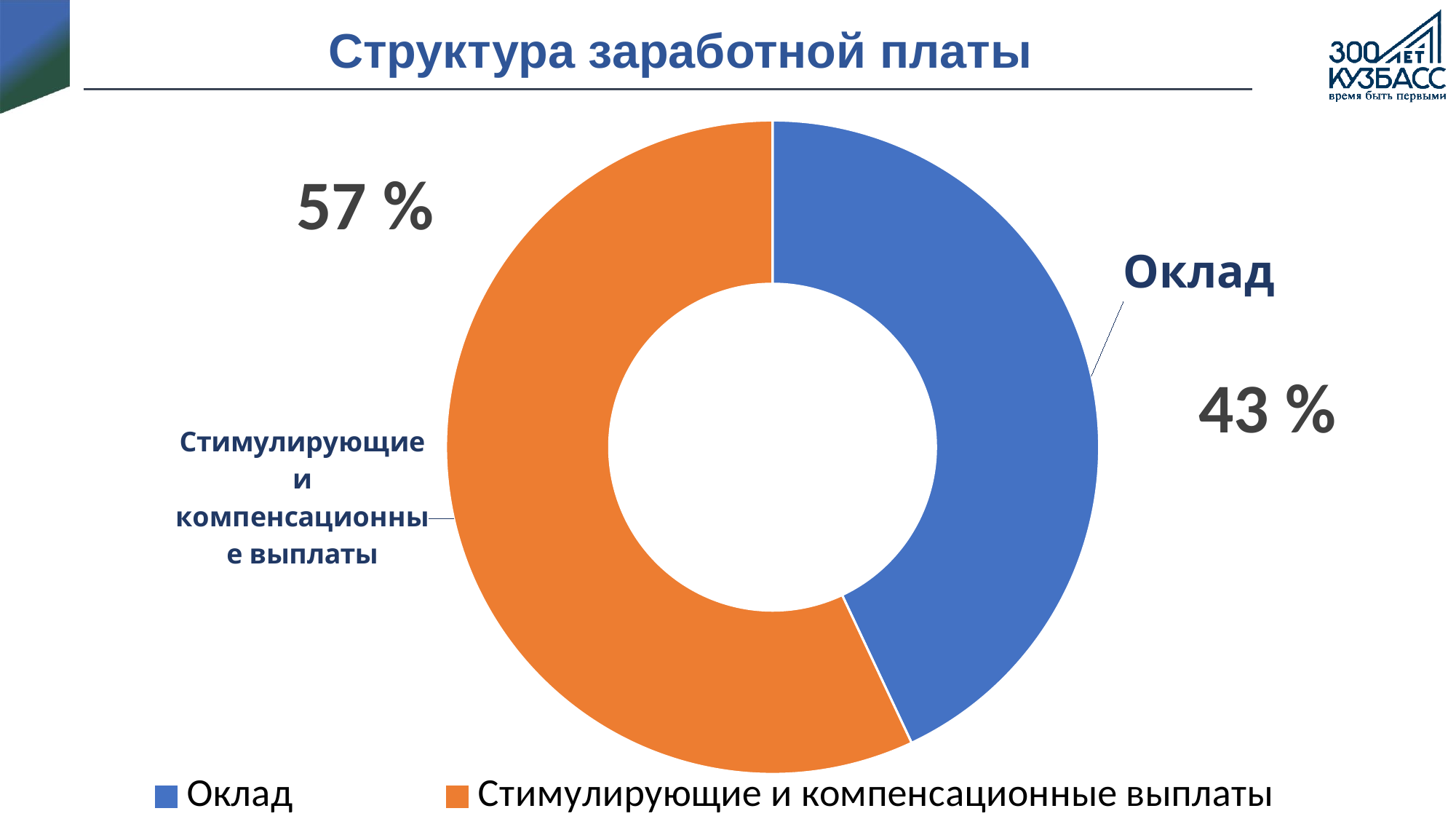
What share of the chart does Оклад represent? 43 % What is the title of the slide? Структура заработной платы What share of the chart does Стимулирующие и компенсационные выплаты represent? 57 % What kind of chart is shown on the slide? Doughnut (pie) chart What is the difference in percentage points between Стимулирующие и компенсационные выплаты and Оклад? 14 Which category has the largest share? Стимулирующие и компенсационные выплаты How many categories are shown in the chart? 2 Is the share for Оклад greater or less than 50%? less How many entries does the legend list? 2 Which category has the smallest share? Оклад What colour represents Оклад in the chart? Blue Which is larger: Оклад or Стимулирующие и компенсационные выплаты? Стимулирующие и компенсационные выплаты